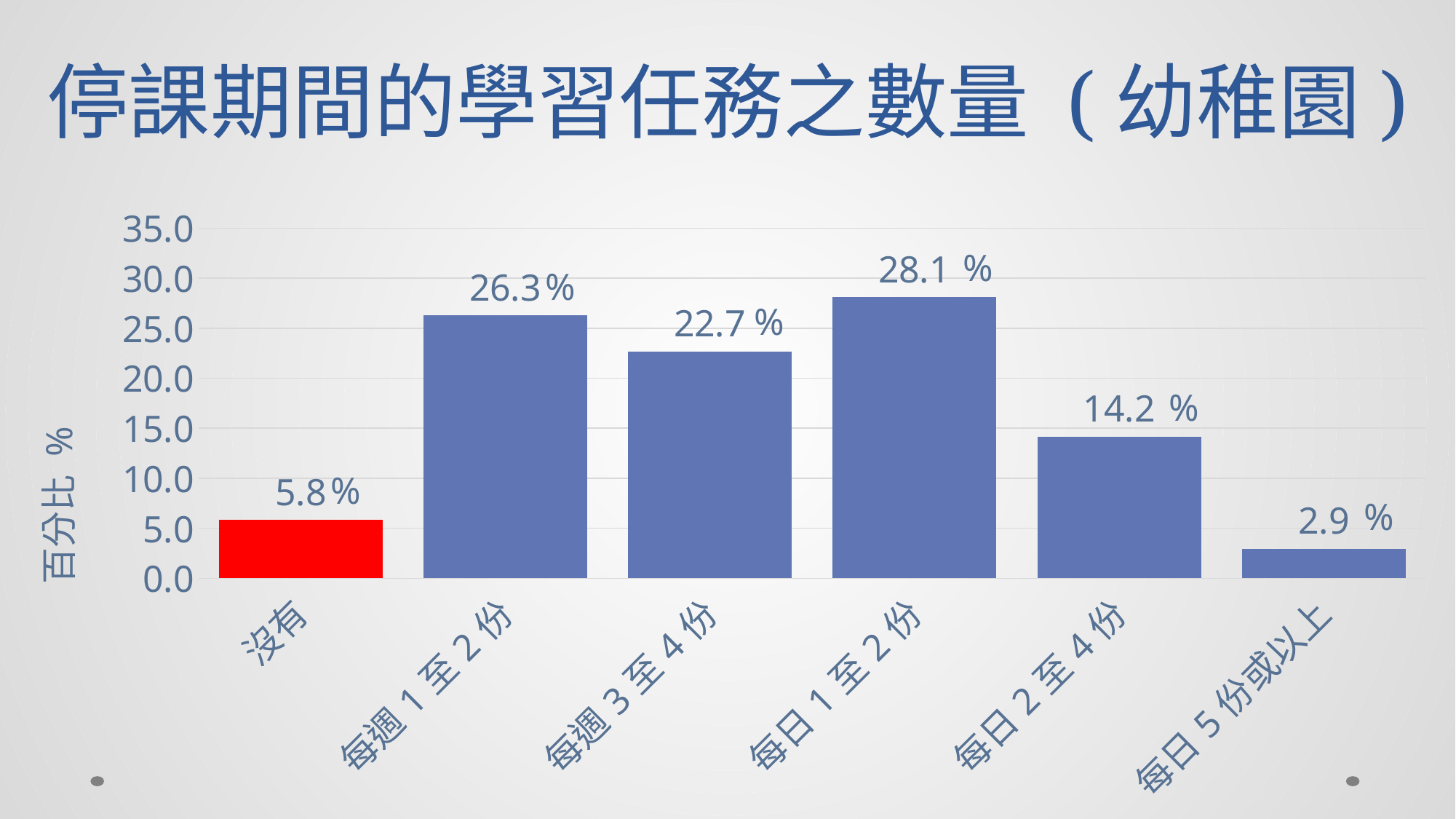
What is the difference between the values for 每週 1 至 2 份 and 每週 3 至 4 份? 3.6% Is the value for 每日 2 至 4 份 greater or less than 15.0? less What is the value for 沒有? 5.8% Which category has the highest value? 每日 1 至 2 份 Which category has the lowest value? 每日 5 份或以上 How many categories are shown on the x axis? 6 What is the value for 每日 1 至 2 份? 28.1% Which is larger, the value for 每日 2 至 4 份 or the value for 每週 3 至 4 份? 每週 3 至 4 份 What kind of chart is shown on the slide? bar chart What is the value for 每日 5 份或以上? 2.9% Which category's bar is coloured red? 沒有 What is the title of the chart? 停課期間的學習任務之數量（幼稚園）